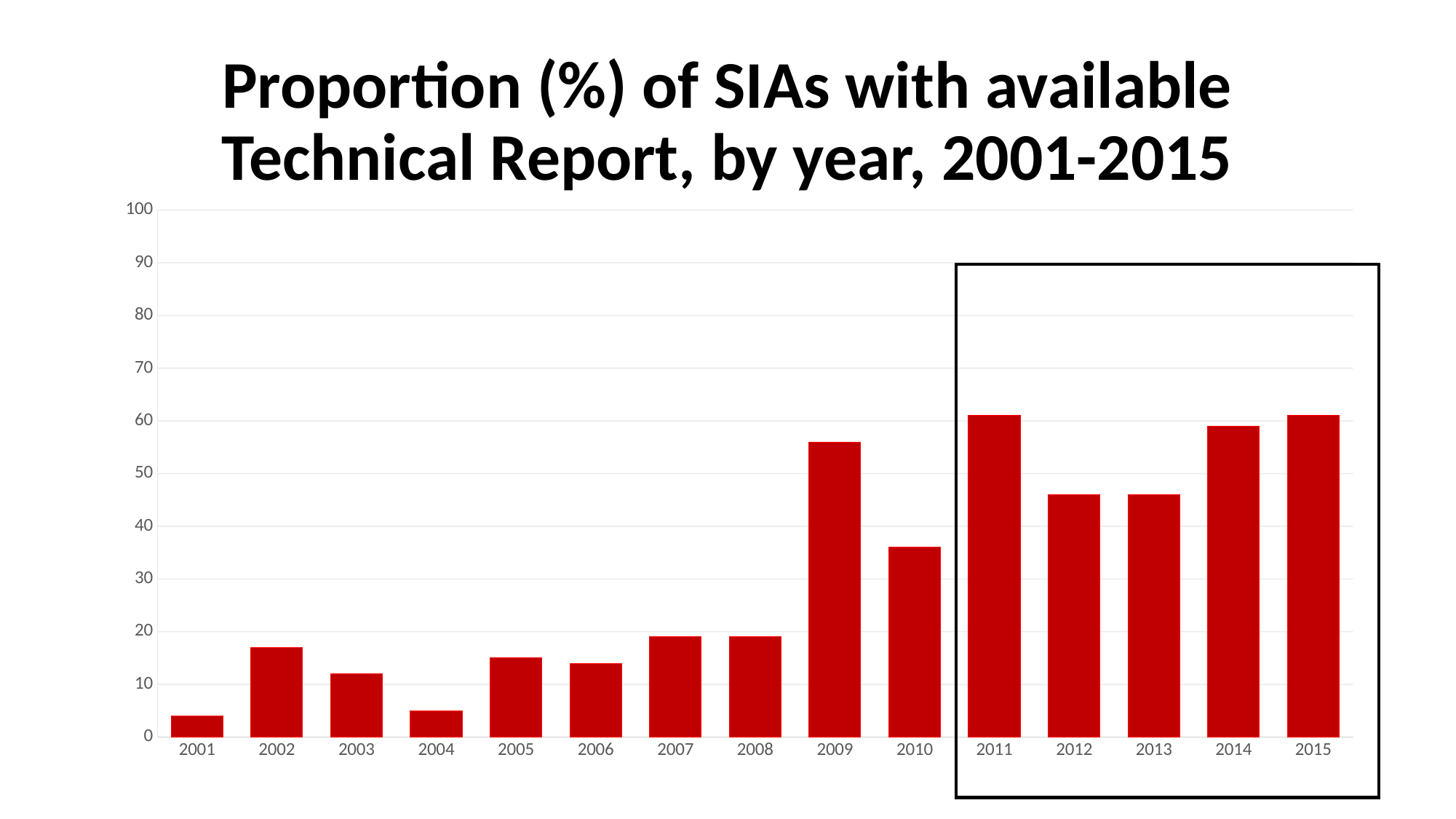
Which year has the lowest proportion of SIAs with an available Technical Report? 2001 Which is larger, the value for 2009 or the value for 2010? 2009 Is the value for 2010 greater or less than 40? less What is the title of the chart? Proportion (%) of SIAs with available Technical Report, by year, 2001-2015 Is the value for 2009 greater or less than 50? greater Is the value for 2004 greater or less than 10? less Which is larger, the value for 2011 or the value for 2012? 2011 What kind of chart is shown on the slide? bar chart Overall, do the values rise or fall from 2001 to 2015? rise How many years are plotted on the x axis? 15